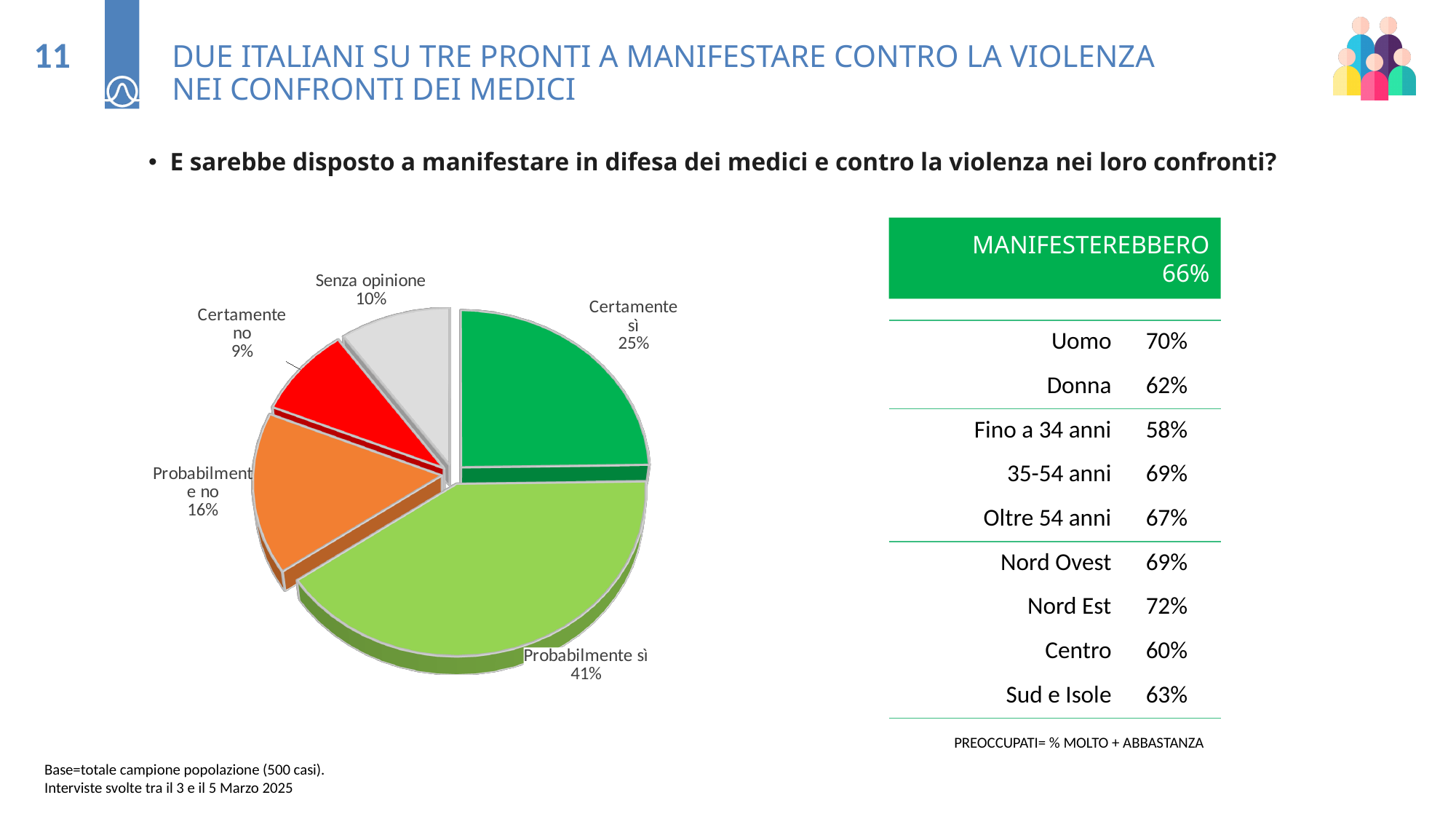
What colour is the "Certamente no" slice? red How many slices does the pie chart have? 5 What is the difference in percentage points between "Probabilmente sì" and "Probabilmente no"? 25 Which response has the smallest slice of the pie? Certamente no What is the combined share of "Certamente sì" and "Probabilmente sì"? 66% Which is larger, the share for "Certamente sì" or the share for "Probabilmente no"? Certamente sì What percentage of respondents answered "Certamente no"? 9% What percentage of respondents answered "Certamente sì"? 25% Which response has the largest slice of the pie? Probabilmente sì What percentage of respondents answered "Senza opinione"? 10% What percentage of respondents answered "Probabilmente sì"? 41% What kind of chart is shown on the slide? pie chart